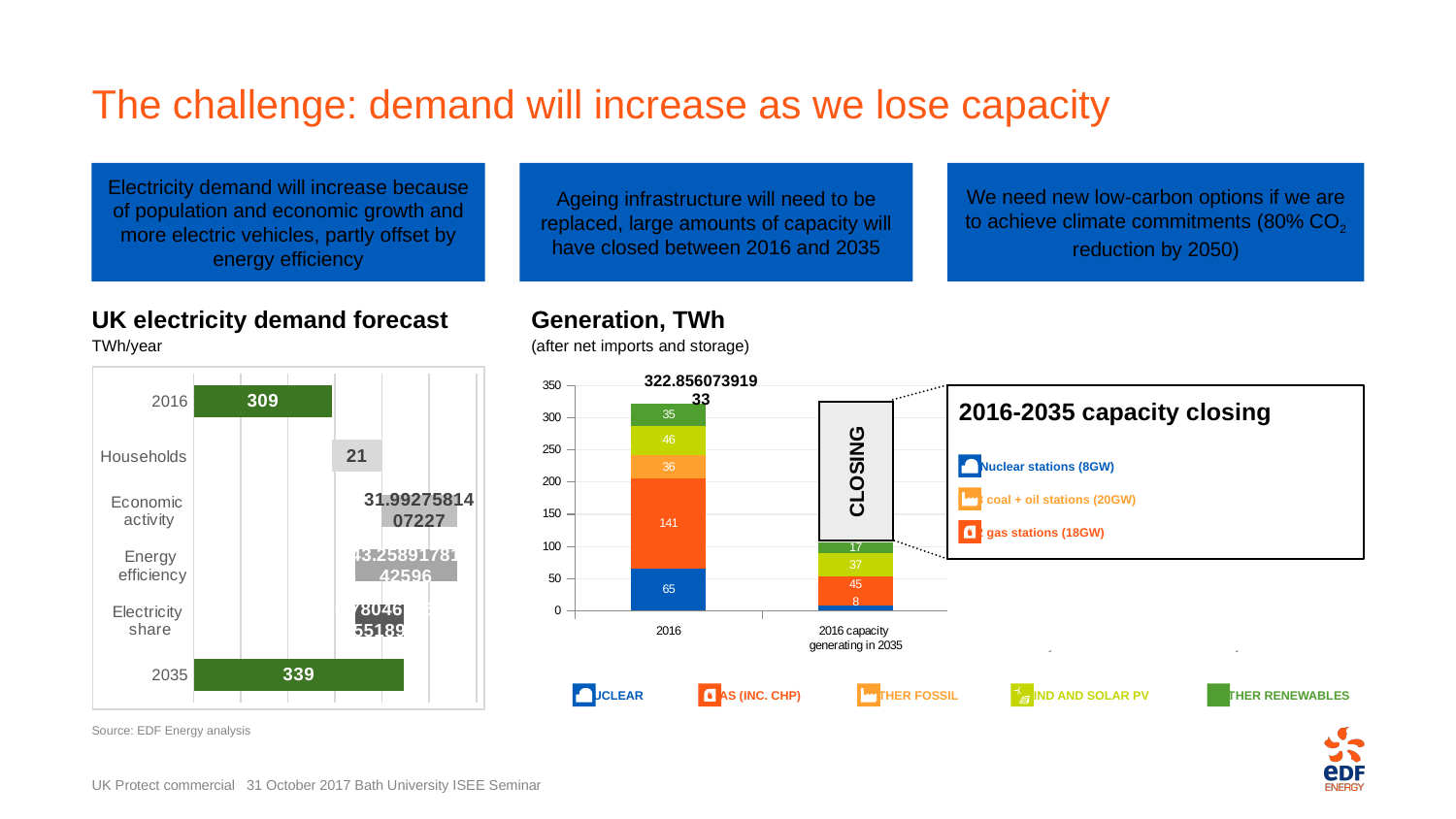
In the Generation, TWh chart, which series has the largest segment in the 2016 bar? Gas (inc. CHP) In the Generation, TWh chart, what is the nuclear value for 2016 capacity generating in 2035? 8 In the Generation, TWh chart, what is the gas (inc. CHP) value for 2016? 141 In the UK electricity demand forecast chart, what is the value for Households? 21 In the UK electricity demand forecast chart, what is the value for 2035? 339 In the UK electricity demand forecast chart, what is the difference between the 2035 and 2016 values? 30 In the Generation, TWh chart, what is the total of the 2016 capacity generating in 2035 bar? 107 What kind of chart is the Generation, TWh chart? Stacked bar chart In the UK electricity demand forecast chart, what is the value for 2016? 309 In the UK electricity demand forecast chart, how many categories are shown on the vertical axis? 6 In the Generation, TWh chart, what is the nuclear value for 2016? 65 In the Generation, TWh chart, how many series does the legend list? 5